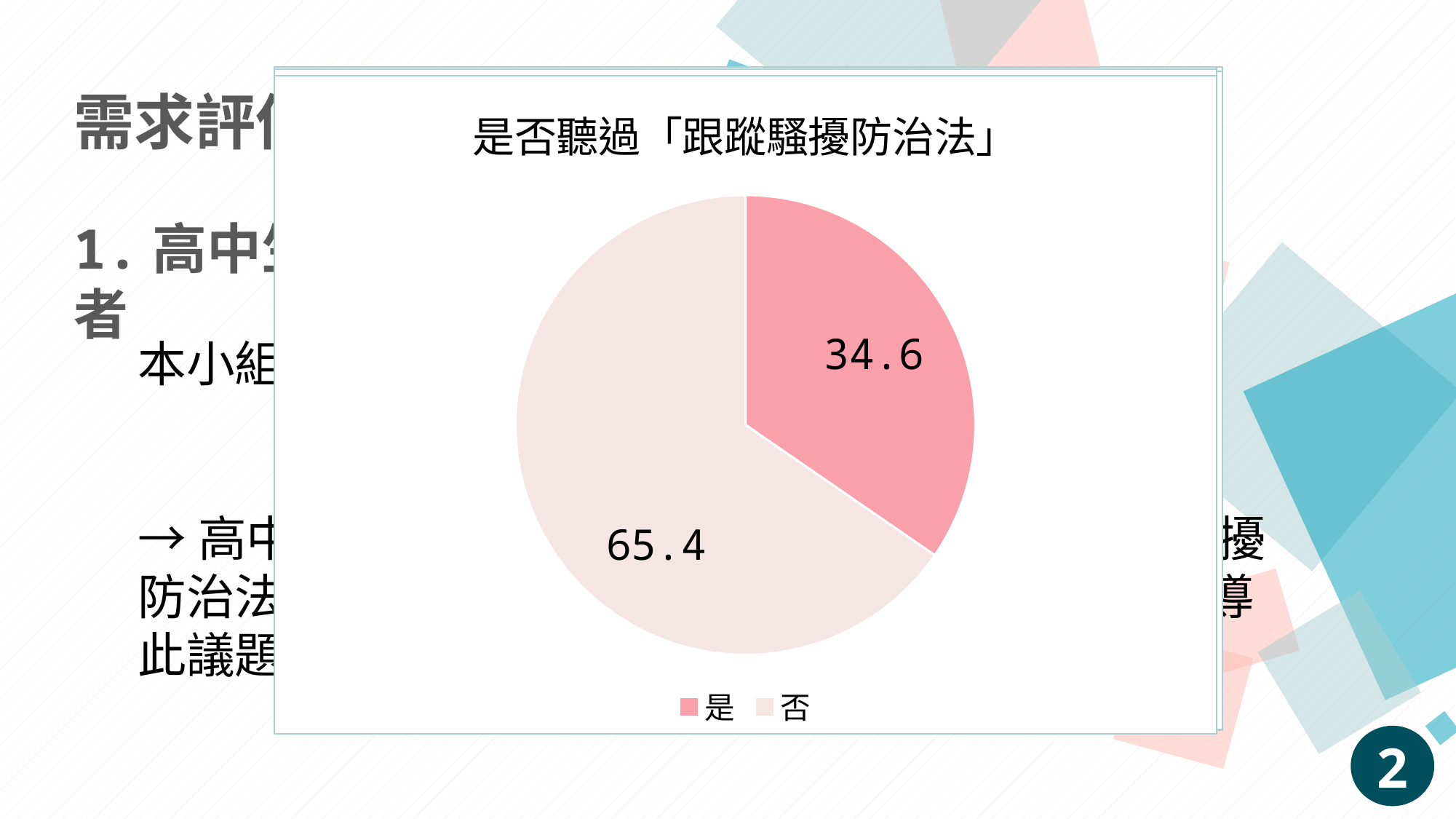
What is the value for 是 (yes) in the pie chart? 34.6 Which legend entry is shown in the darker pink colour? 是 How many slices does the pie chart have? 2 What kind of chart is shown on the slide? pie chart What is the difference between the values for 否 and 是? 30.8 Which category has the smallest slice of the pie? 是 What is the title of the chart? 是否聽過「跟蹤騷擾防治法」 Which category has the largest slice of the pie? 否 What is the value for 否 (no) in the pie chart? 65.4 How many entries does the legend list? 2 Which is larger, the value for 是 or the value for 否? 否 What is the total of the two values shown in the pie chart? 100